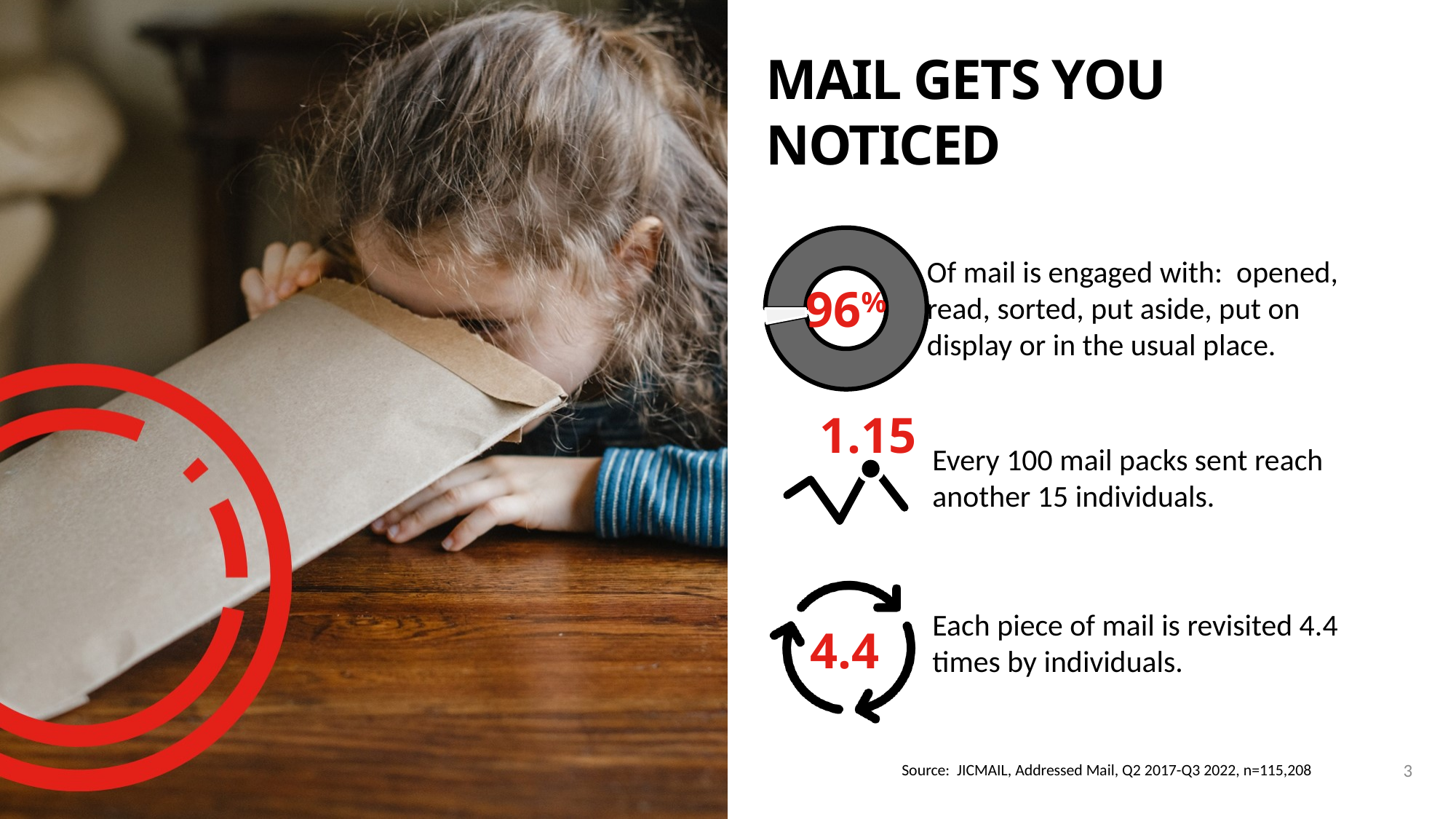
Which segment of the donut chart is larger, the grey one or the white one? The grey one What does the 96% in the donut chart represent, according to the text beside it? Mail that is engaged with: opened, read, sorted, put aside, put on display or in the usual place What colour is the large segment of the donut chart? Grey How many segments does the donut chart have? 2 What kind of chart is shown next to the text 'Of mail is engaged with'? Donut (pie) chart What percentage is printed in the centre of the donut chart? 96%